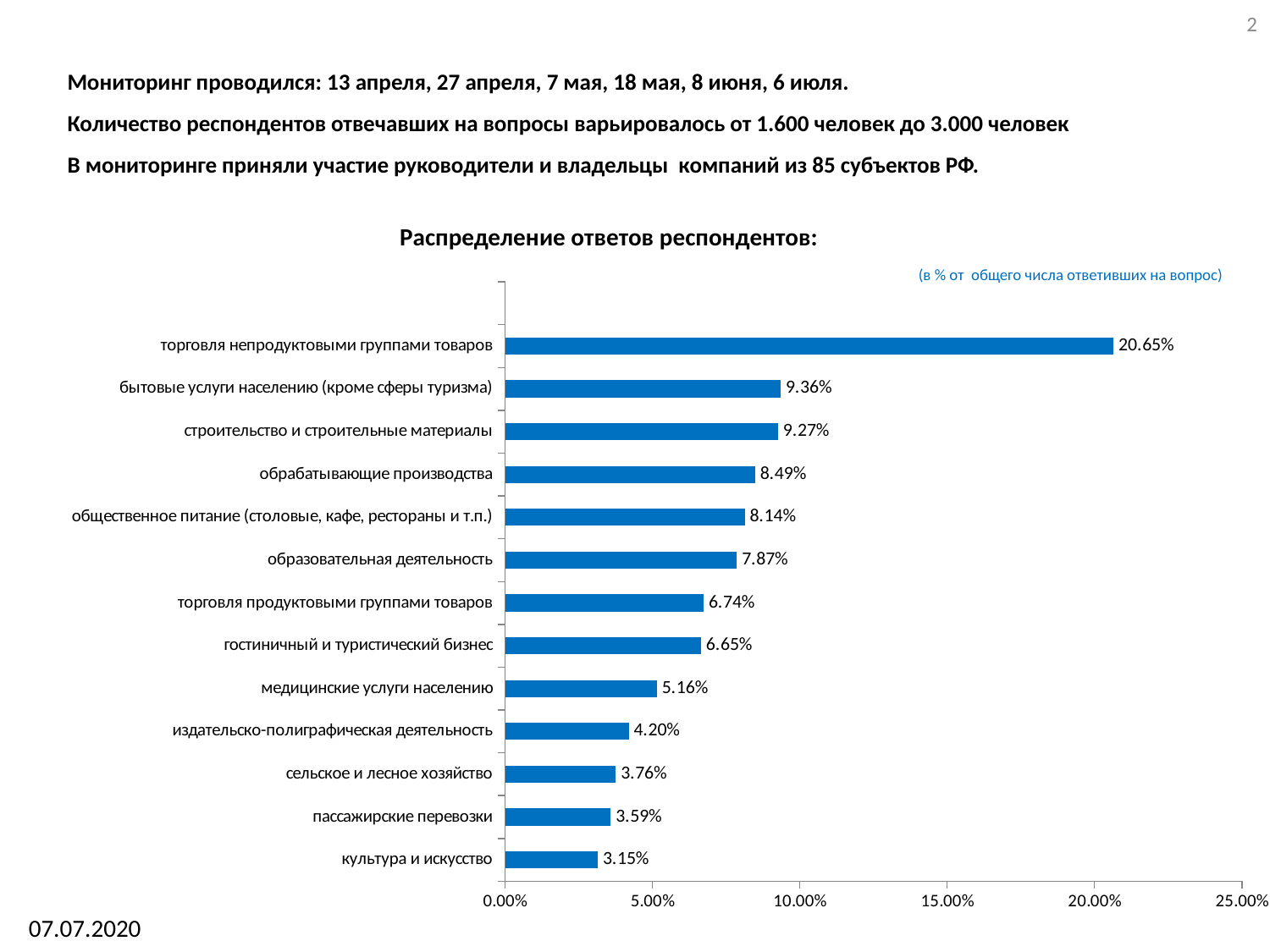
Which category has the highest value? торговля непродуктовыми группами товаров Which category has the lowest value? культура и искусство What is the difference between сельское и лесное хозяйство and пассажирские перевозки? 0.17% What kind of chart is shown on the slide? bar chart Which is larger: образовательная деятельность or гостиничный и туристический бизнес? образовательная деятельность What is the value for медицинские услуги населению? 5.16% Is the value for общественное питание (столовые, кафе, рестораны и т.п.) greater or less than 5.00%? greater What is the title of the chart? Распределение ответов респондентов: How many categories are shown in the chart? 13 What is the value for торговля непродуктовыми группами товаров? 20.65% What is the difference between торговля непродуктовыми группами товаров and бытовые услуги населению (кроме сферы туризма)? 11.29% What is the value for обрабатывающие производства? 8.49%